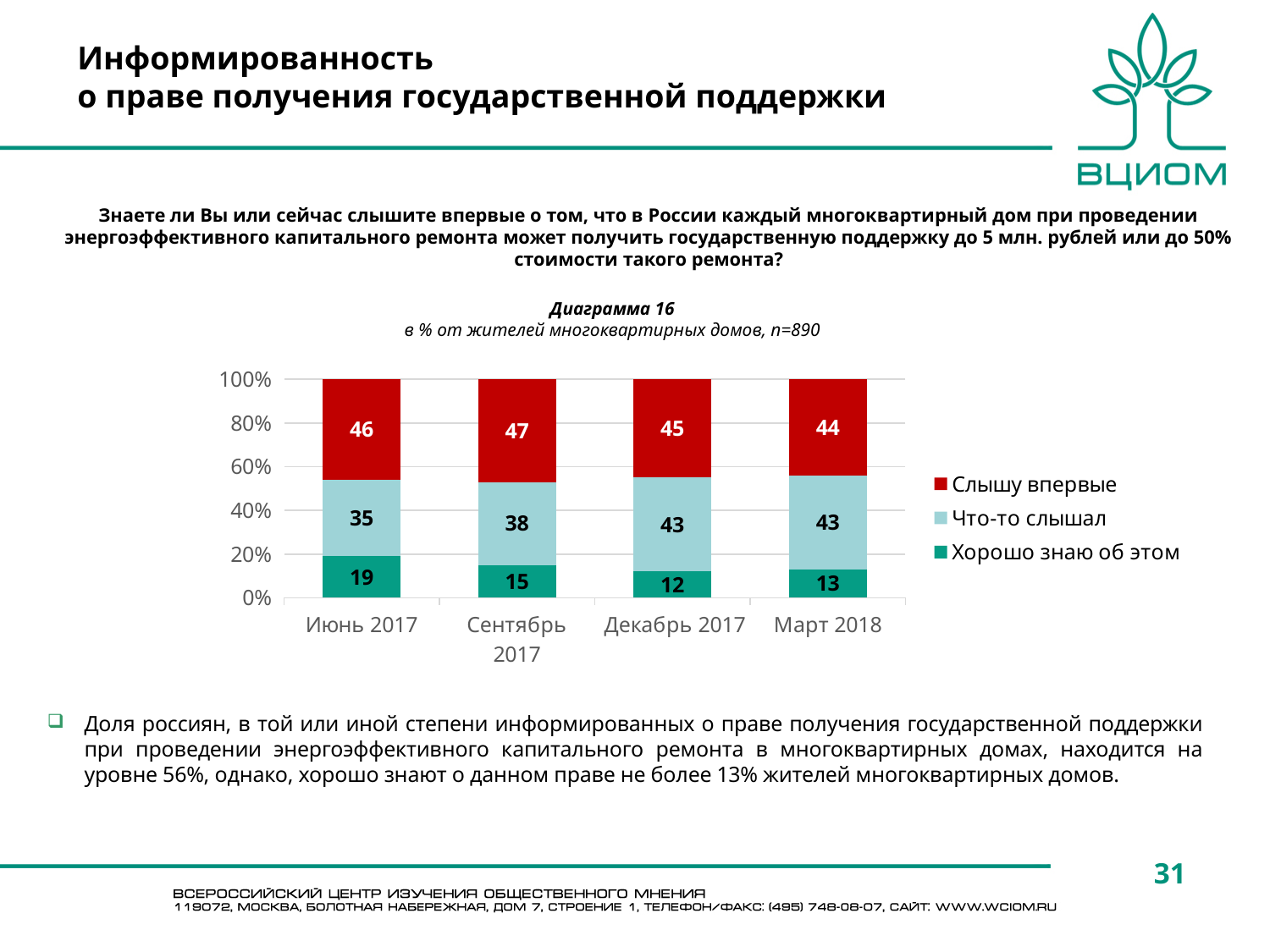
What is the value for "Хорошо знаю об этом" in Март 2018? 13 How many periods are shown on the x axis? 4 What kind of chart is shown? Stacked bar chart Which is larger in Сентябрь 2017: "Слышу впервые" or "Что-то слышал"? Слышу впервые What is the difference between the "Что-то слышал" values for Декабрь 2017 and Июнь 2017? 8 How many series does the legend list? 3 What is the value for "Что-то слышал" in Сентябрь 2017? 38 What is the value for "Слышу впервые" in Июнь 2017? 46 In which period is the value for "Хорошо знаю об этом" the highest? Июнь 2017 What is the sample size (n) stated in the chart subtitle? n=890 In which period is the value for "Хорошо знаю об этом" the lowest? Декабрь 2017 Does the value for "Слышу впервые" rise or fall from Сентябрь 2017 to Март 2018? Fall